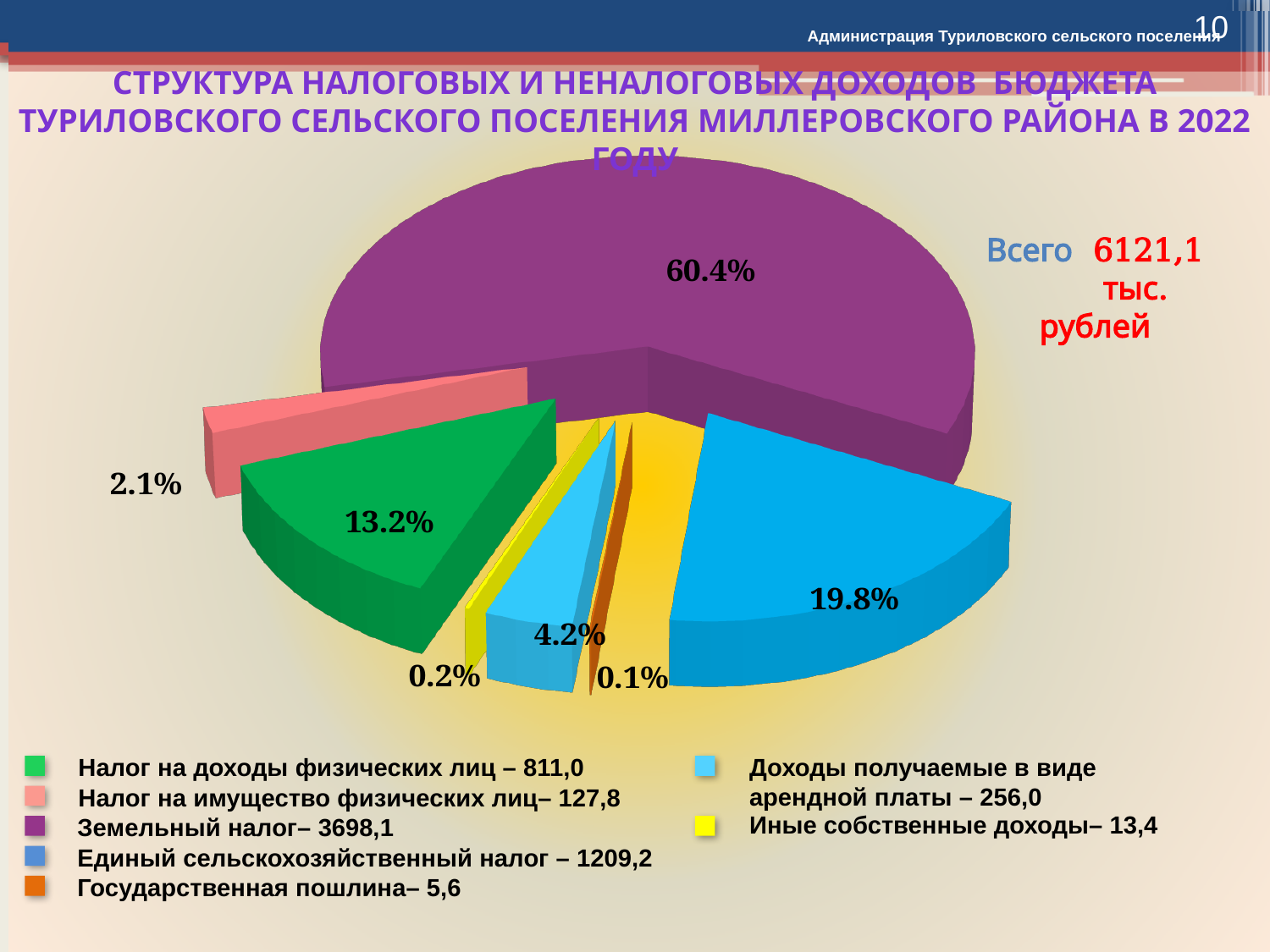
What total amount (Всего) is stated on the slide? 6121,1 тыс. рублей What share of the pie does the pink slice (Налог на имущество физических лиц) represent? 2.1% How many slices does the pie chart have? 7 What is the smallest share shown on the pie chart? 0.1% Which is larger, the share labelled 19.8% or the share labelled 13.2%? 19.8% What share of the pie does the purple slice (Земельный налог) represent? 60.4% What share of the pie does the green slice (Налог на доходы физических лиц) represent? 13.2% What is the largest share shown on the pie chart? 60.4% What is the difference in percentage points between the 60.4% slice and the 19.8% slice? 40.6 What is the value for Земельный налог given in the legend? 3698,1 What kind of chart is shown on the slide? pie chart What is the value for Единый сельскохозяйственный налог given in the legend? 1209,2